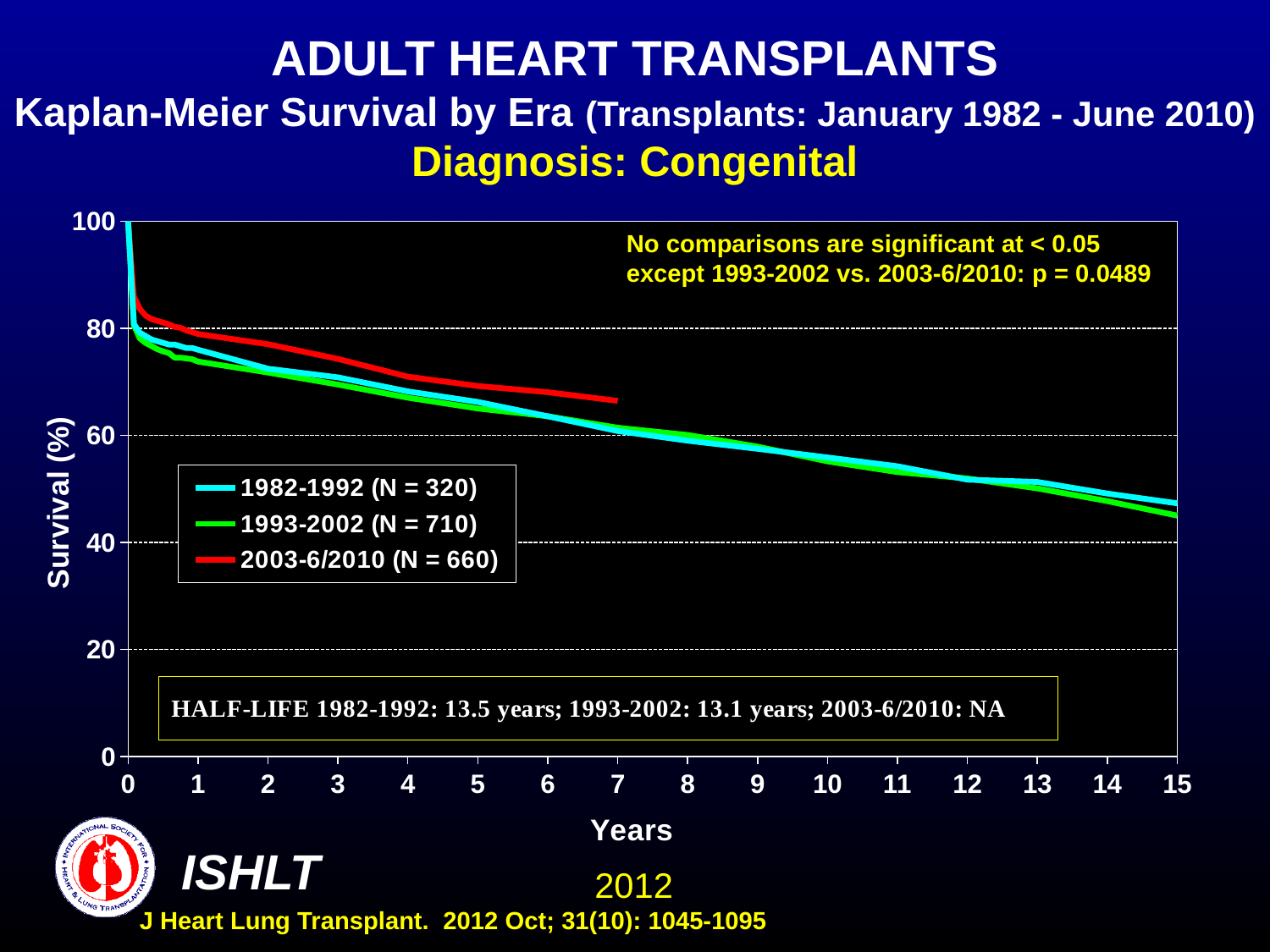
Do the survival curves rise or fall as years increase? fall What is the N shown in the legend for the 1993-2002 era? 710 At 5 years, which era has higher survival: 2003-6/2010 or 1993-2002? 2003-6/2010 What diagnosis does the chart title specify? Congenital Is the survival for 1993-2002 at 10 years greater or less than 60? less How many series does the legend list? 3 At 3 years, which era has higher survival: 2003-6/2010 or 1982-1992? 2003-6/2010 Which era has the highest survival at 5 years? 2003-6/2010 What kind of chart is shown on the slide? line chart Is the survival for 2003-6/2010 at 5 years greater or less than 60? greater Is the survival for 1982-1992 at 15 years greater or less than 60? less